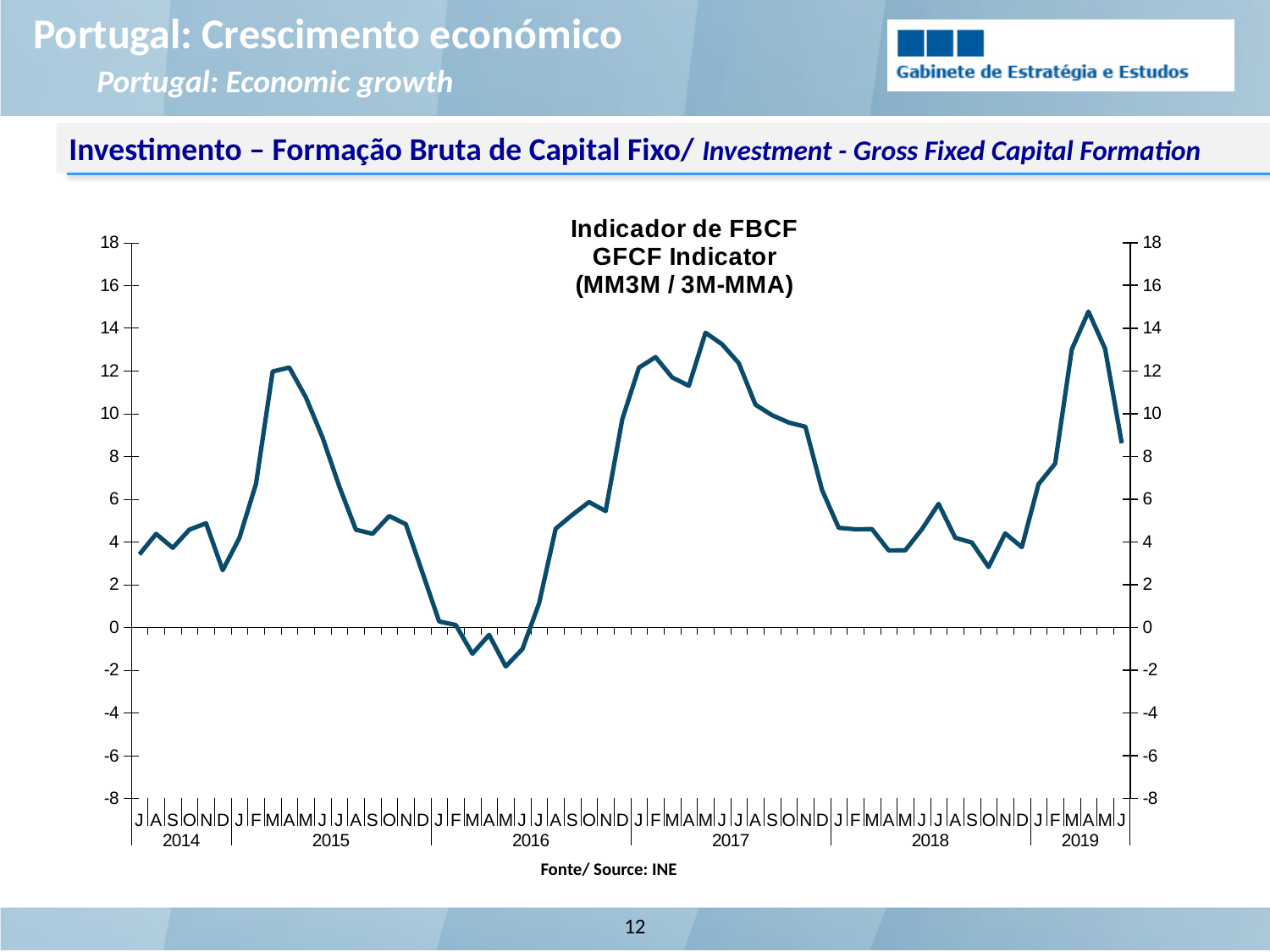
Is the value for June 2019 greater or less than 10? less How many data series are plotted in the chart? 1 Is the value for May 2016 greater or less than 0? less What is the title of the chart? Indicador de FBCF / GFCF Indicator (MM3M / 3M-MMA) What source is cited below the chart? INE How many years are labelled along the x axis of the chart? 6 Is the value for April 2015 greater or less than 10? greater Does the line rise or fall between April 2019 and June 2019? fall What kind of chart is shown on the slide? line chart In which year does the line reach its highest peak? 2019 In which year does the line reach its lowest point? 2016